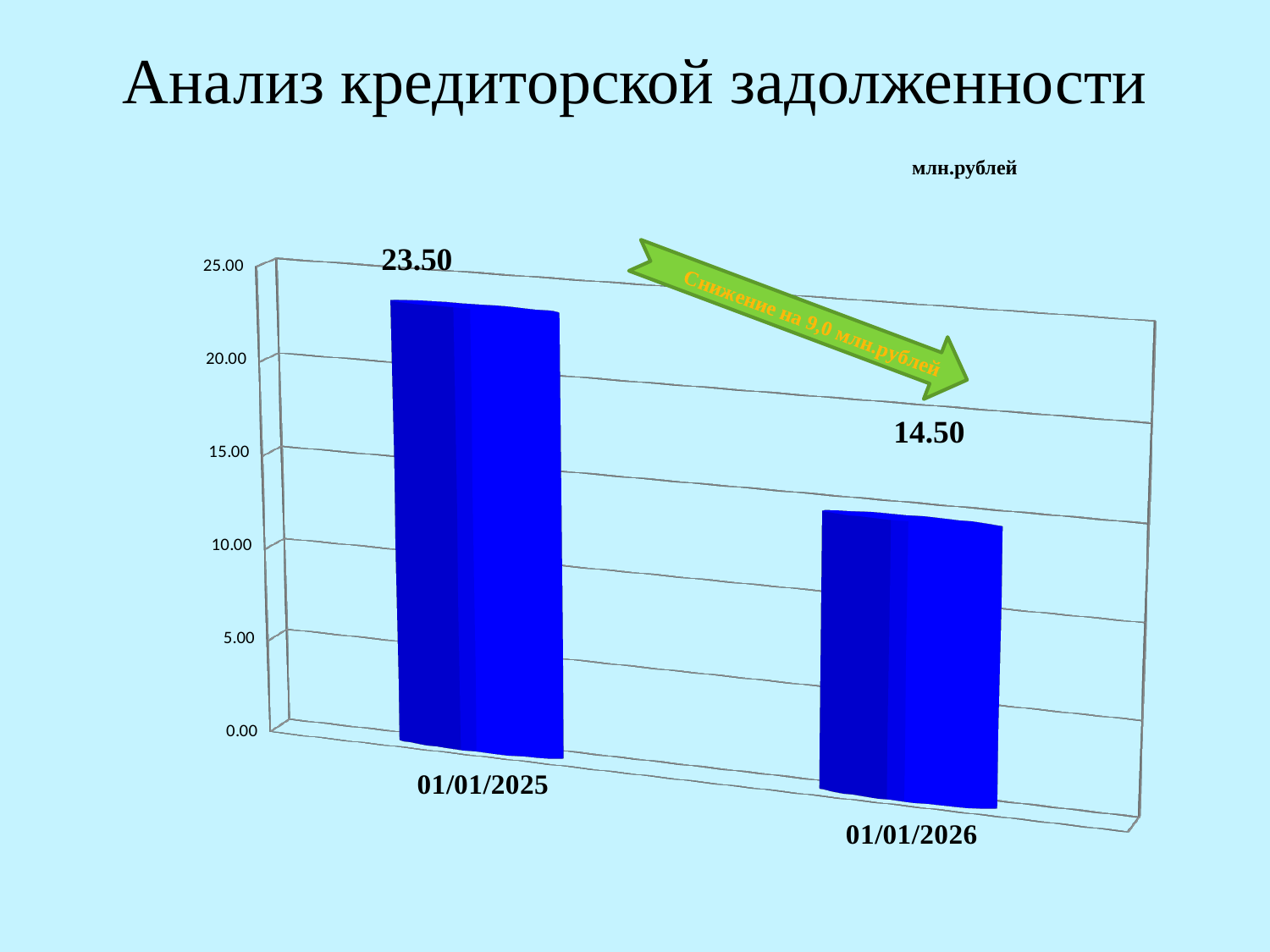
Which date has the lower value? 01/01/2026 Is the value for 01/01/2026 greater or less than 20.00? less How many bars are shown in the chart? 2 Which date has the higher value? 01/01/2025 Do the values rise or fall from 01/01/2025 to 01/01/2026? fall What kind of chart is shown on the slide? bar chart Is the value for 01/01/2025 larger or smaller than the value for 01/01/2026? larger What is the difference between the values for 01/01/2025 and 01/01/2026? 9.00 What is the value for 01/01/2026? 14.50 Is the value for 01/01/2025 greater or less than 20.00? greater What is the value for 01/01/2025? 23.50 What unit is indicated for the chart values? млн.рублей